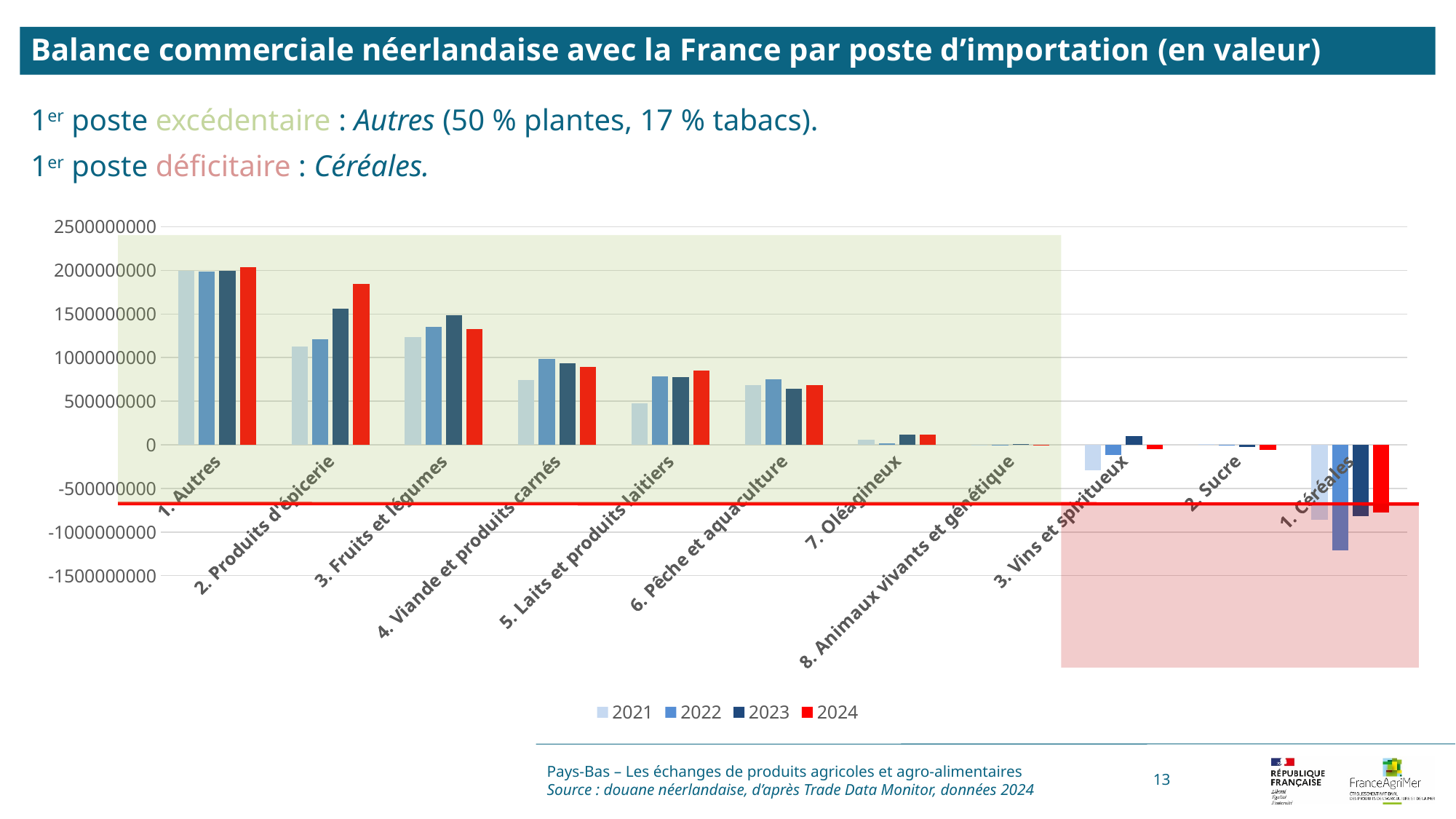
Is the 2022 value for 1. Céréales greater or less than -1000000000? less Which colour represents the 2024 series in the legend? red Which category has the highest value for 2024? 1. Autres Is the 2024 value for 2. Produits d'épicerie greater or less than 1500000000? greater What kind of chart is shown on the slide? bar chart Do the 2024 values generally rise or fall moving from left to right along the x axis? fall For 1. Céréales, which year has the larger (less negative) value, 2022 or 2023? 2023 For 3. Fruits et légumes, which year has the larger value, 2023 or 2024? 2023 Which category has the lowest value for 2024? 1. Céréales How many categories are shown on the x axis of the chart? 11 How many series does the legend list? 4